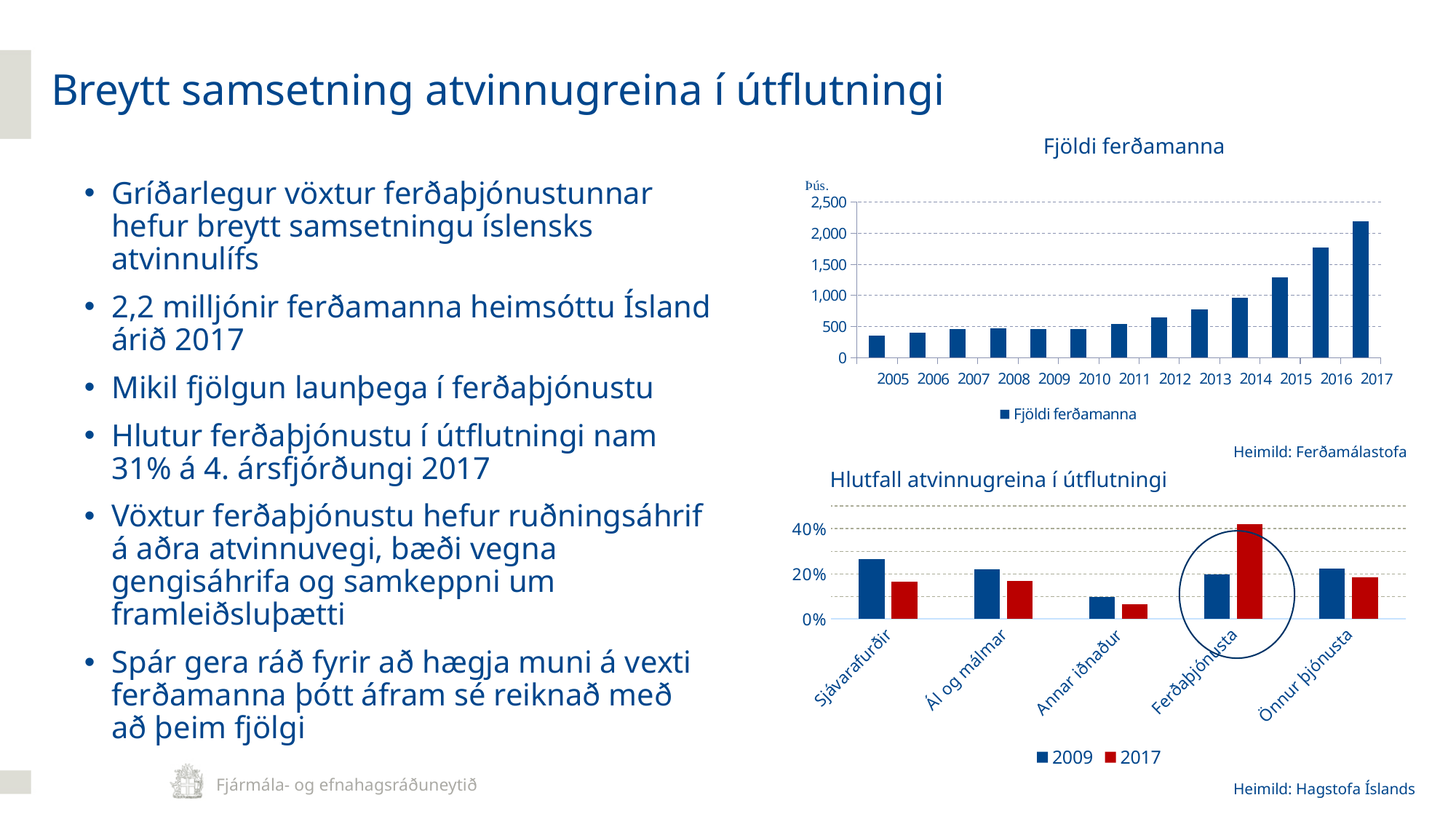
In the "Fjöldi ferðamanna" chart, which year has the highest value? 2017 In the "Fjöldi ferðamanna" chart, is the value for 2017 greater or less than 2,000? greater In the "Fjöldi ferðamanna" chart, how many years are shown on the x axis? 13 In the "Hlutfall atvinnugreina í útflutningi" chart, how many categories are shown on the x axis? 5 In the "Fjöldi ferðamanna" chart, what unit is shown at the top of the y axis? Þús. How many series does the legend of the "Hlutfall atvinnugreina í útflutningi" chart list? 2 In the "Fjöldi ferðamanna" chart, which year has the lowest value? 2005 In the "Fjöldi ferðamanna" chart, is the value for 2013 greater or less than 1,000? less In the "Hlutfall atvinnugreina í útflutningi" chart, is the 2017 value for Ferðaþjónusta greater or less than 40%? greater In the "Fjöldi ferðamanna" chart, do the values generally rise or fall from 2010 to 2017? rise What kind of chart is the "Fjöldi ferðamanna" chart? bar chart In the "Hlutfall atvinnugreina í útflutningi" chart, which category has the highest 2017 value? Ferðaþjónusta